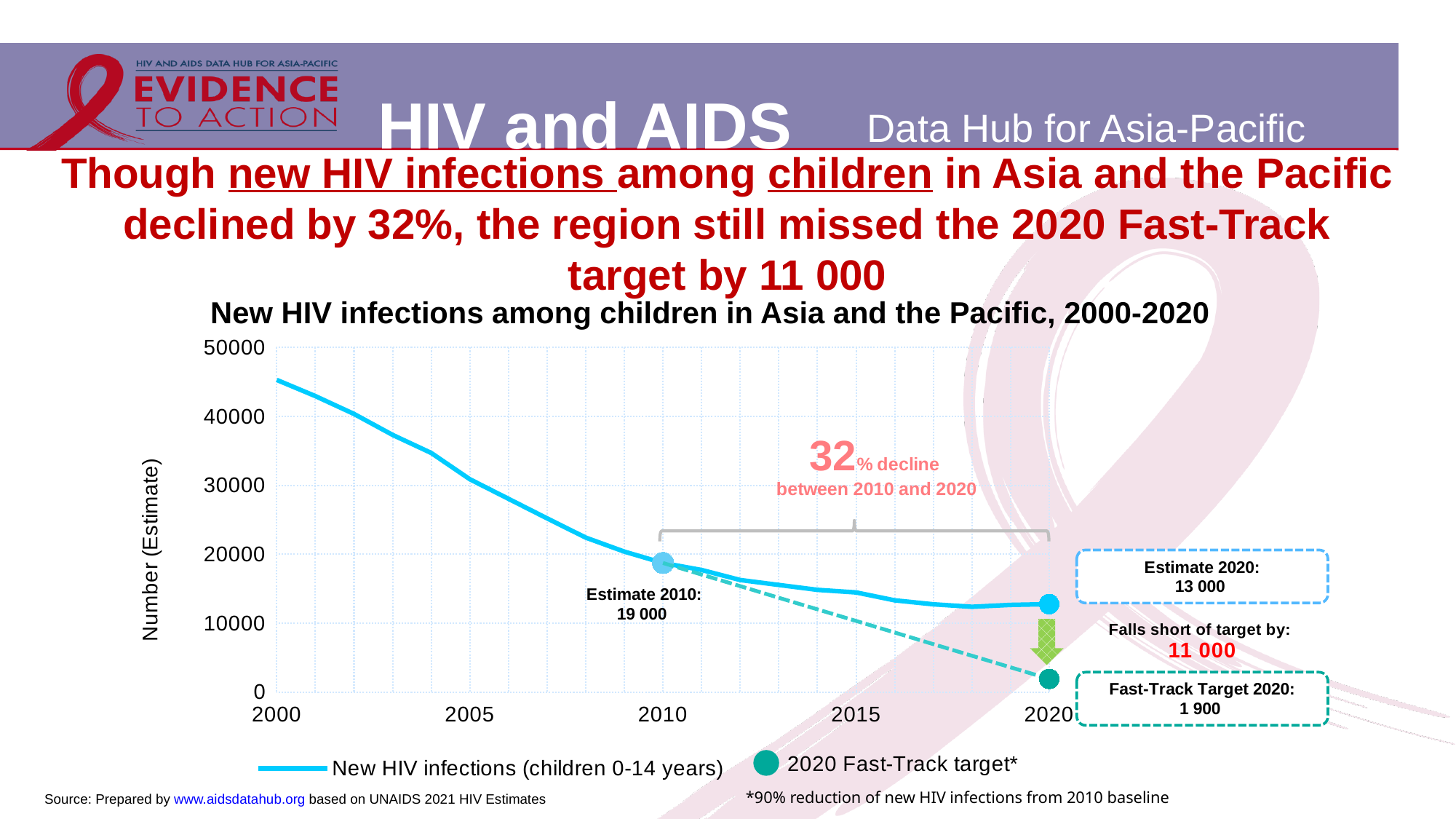
Is the value for new HIV infections among children in 2015 greater or less than 20000? less By how much does the 2020 estimate fall short of the 2020 Fast-Track target? 11 000 What is the estimated number of new HIV infections among children in 2010? 19 000 What is the percentage decline in new HIV infections among children between 2010 and 2020? 32% Which is larger, the 2010 estimate or the 2020 estimate of new HIV infections among children? 2010 estimate Is the value for new HIV infections among children in 2000 greater or less than 40000? greater What type of chart is used to show new HIV infections among children in Asia and the Pacific? line chart Do new HIV infections among children rise or fall from 2000 to 2020? fall What is the estimated number of new HIV infections among children in 2020? 13 000 How many entries does the chart legend list? 2 What is the 2020 Fast-Track target for new HIV infections among children? 1 900